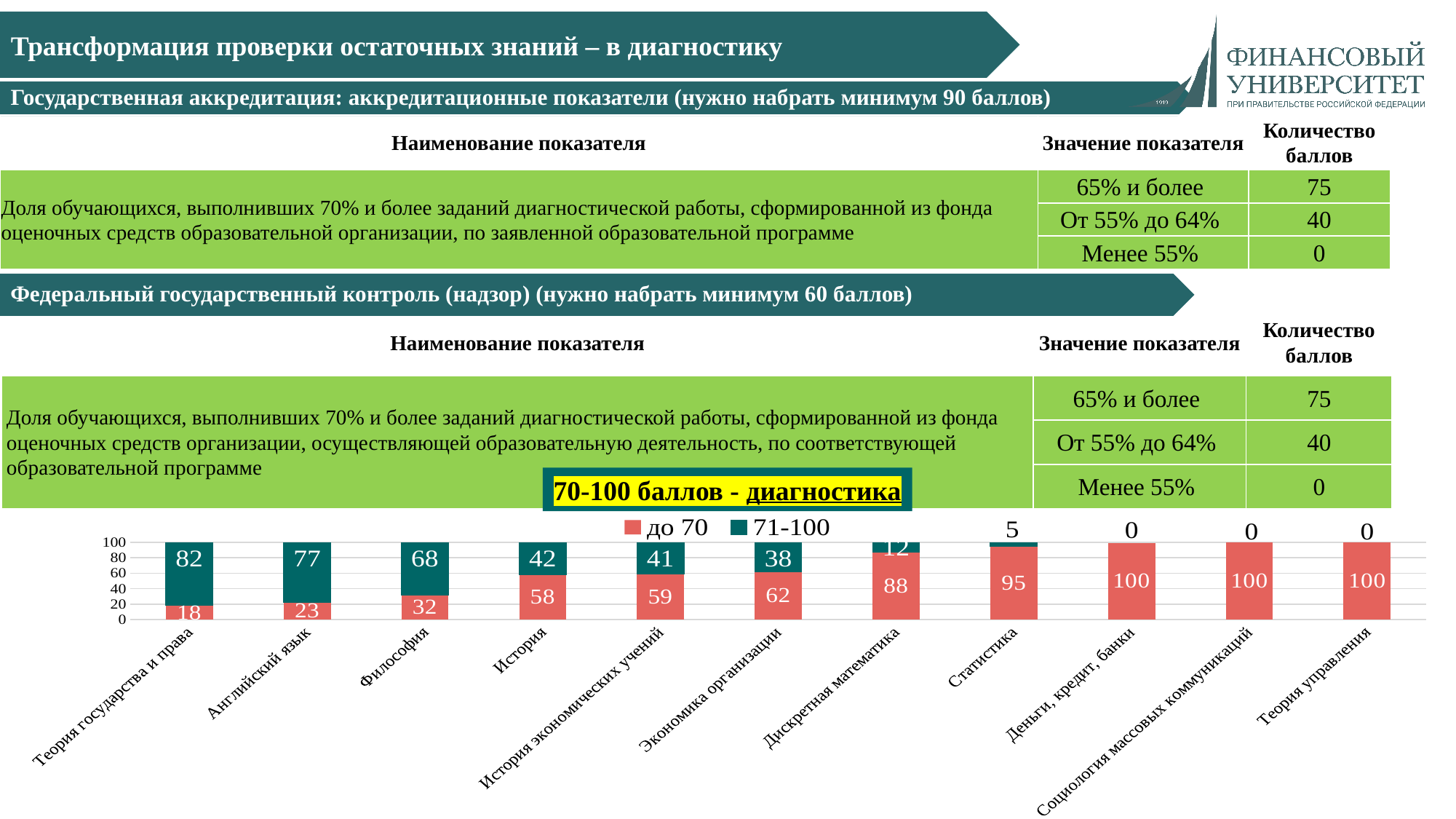
Which category has the highest value in the "71-100" series? Теория государства и права What is the value of the "71-100" series for Теория государства и права? 82 Which category has the lowest value in the "до 70" series? Теория государства и права What is the value of the "до 70" series for Философия? 32 How many categories (disciplines) are shown on the x axis of the chart? 11 Which series in the legend is shown in red? до 70 What is the value of the "71-100" series for Дискретная математика? 12 What kind of chart is shown at the bottom of the slide? stacked bar chart Which is larger: the "71-100" value for Английский язык or for Философия? Английский язык What is the difference between the "до 70" values for Статистика and История? 37 What is the total of the stacked bar for Экономика организации? 100 How many series does the chart legend list? 2